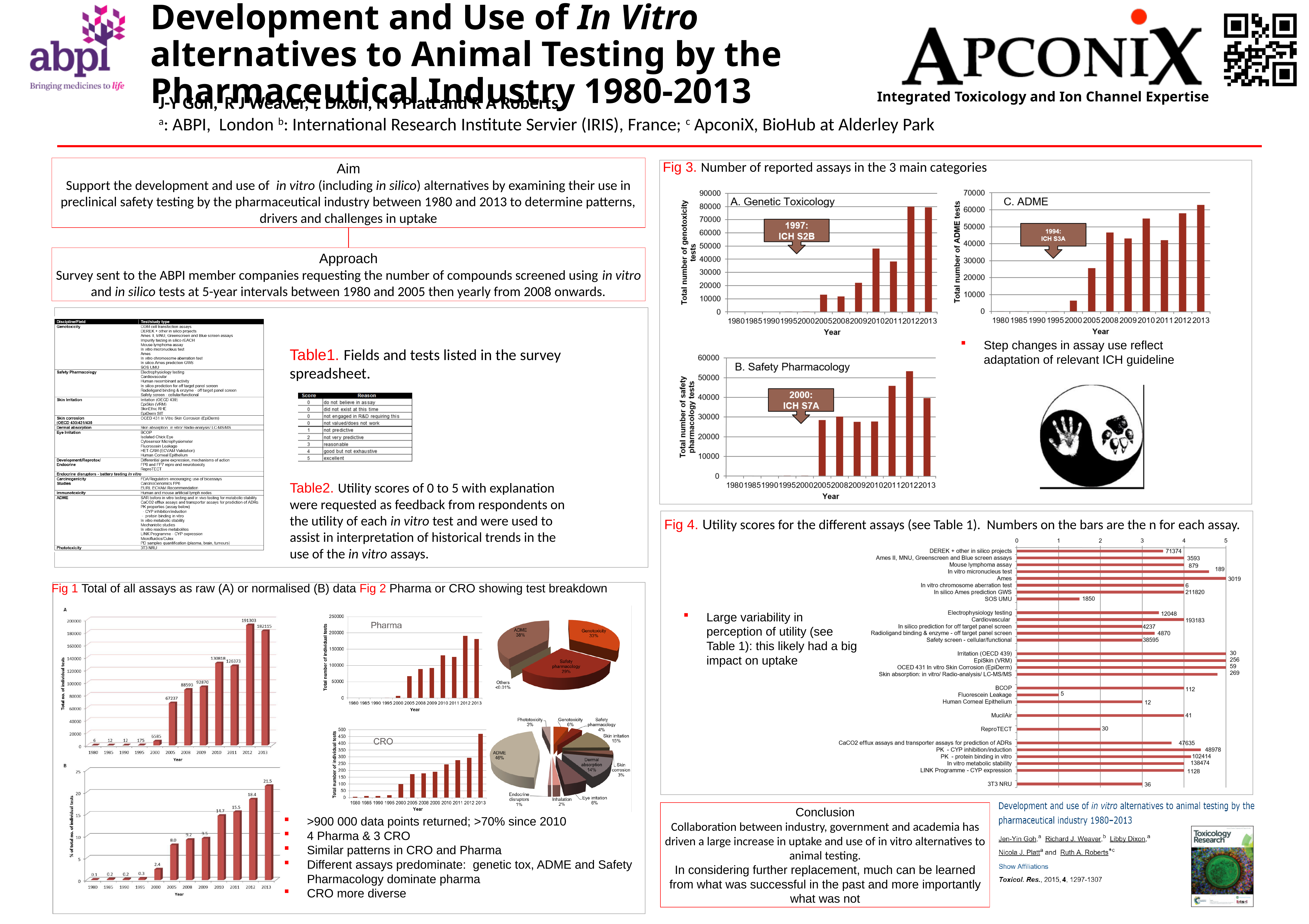
In Fig 1 chart A (total of all assays, raw data), which is larger, the value for 2000 or the value for 2005? 2005 In Fig 1 chart B (normalised data), what is the value for 2013? 21.5 In Fig 3 chart B (Safety Pharmacology), which year has the highest value? 2012 In the Fig 2 CRO pie chart, which category has the largest slice? ADME How many years are plotted in Fig 1 chart A (total of all assays, raw data)? 12 In Fig 1 chart B (normalised data), what is the difference between the values for 2013 and 2012? 3.1 In Fig 1 chart A (total of all assays, raw data), what is the value for 2012? 191303 In Fig 3 chart A (Genetic Toxicology), is the value for 2010 greater or less than 40000? greater In Fig 3 chart C (ADME), is the value for 2000 greater or less than 10000? less In the Fig 2 Pharma pie chart, what share does ADME have? 38% What kind of chart is Fig 3 chart C (ADME)? bar chart In Fig 1 chart A (total of all assays, raw data), which year has the highest value? 2012